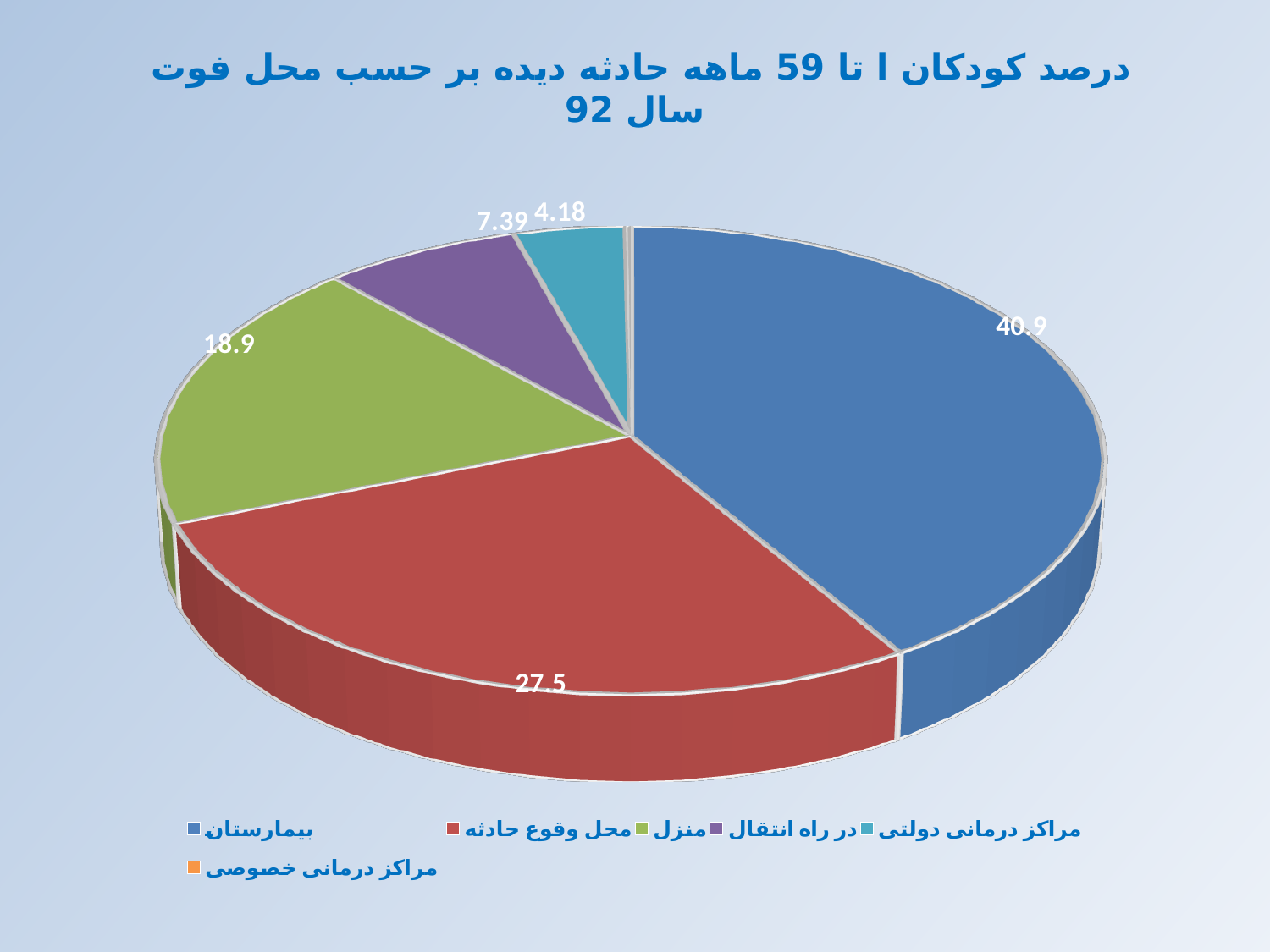
What is the value shown for the بیمارستان (hospital) slice? 40.9 Which category has the largest slice of the pie? بیمارستان What is the difference between the بیمارستان value and the محل وقوع حادثه value? 13.4 What type of chart is shown on the slide? Pie chart What is the value shown for the در راه انتقال (during transfer) slice? 7.39 Among the slices with printed values, which category has the smallest value? مراکز درمانی دولتی What is the value shown for the منزل (home) slice? 18.9 Which is larger, the value for منزل or the value for در راه انتقال? منزل What is the value shown for the محل وقوع حادثه (accident site) slice? 27.5 What colour is the slice representing بیمارستان (hospital)? Blue What is the value shown for the مراکز درمانی دولتی (public health centers) slice? 4.18 How many entries does the legend list? 6